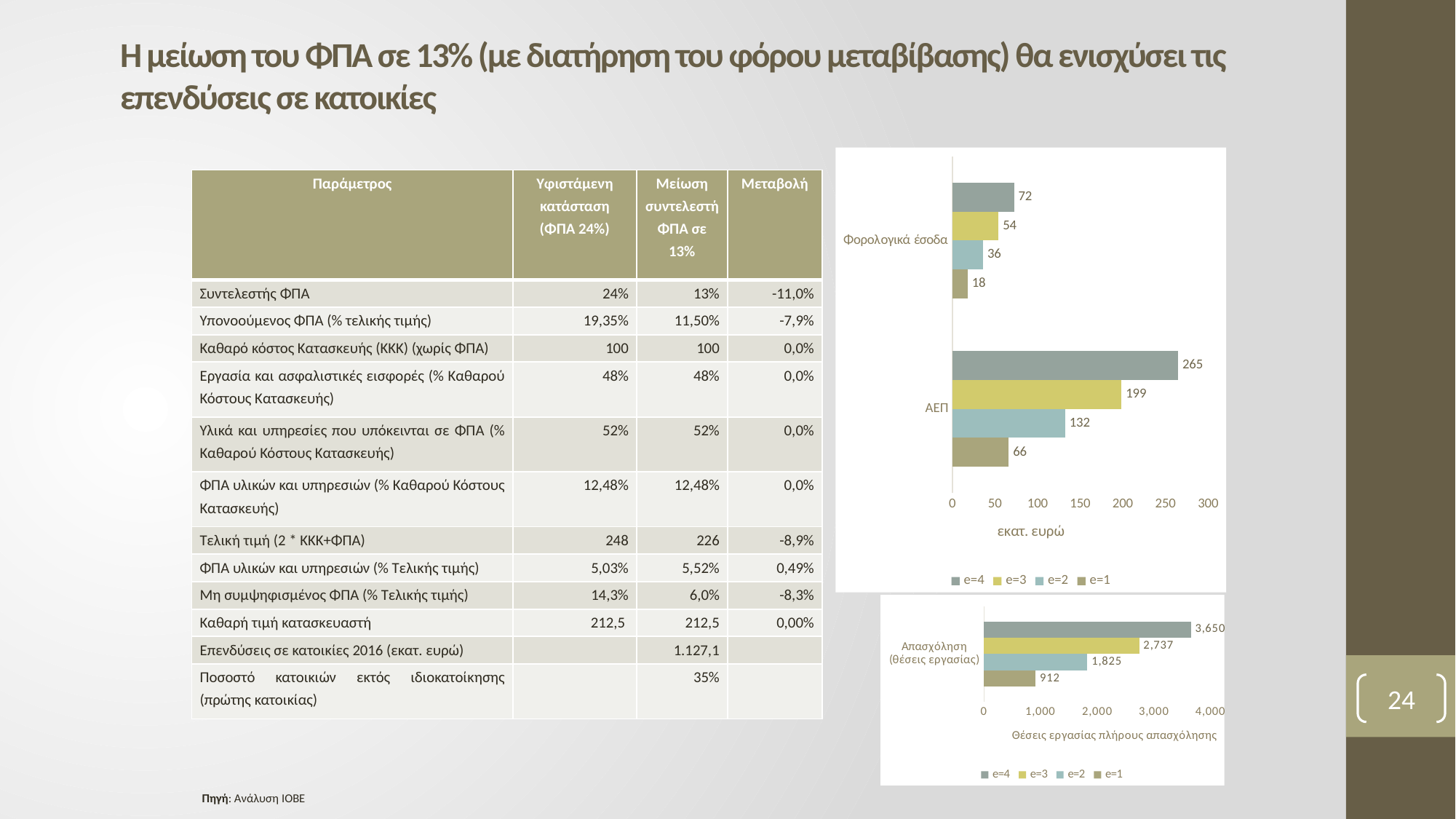
In the upper chart (εκατ. ευρώ), which series has the lowest value for Φορολογικά έσοδα? e=1 What kind of chart is the lower chart (Απασχόληση)? Bar chart In the upper chart (εκατ. ευρώ), what is the value of Φορολογικά έσοδα for e=2? 36 How many series does the legend of the upper chart (εκατ. ευρώ) list? 4 In the upper chart (εκατ. ευρώ), what is the difference between the ΑΕΠ values for e=4 and e=1? 199 In the lower chart (Απασχόληση), what is the difference between the values for e=4 and e=2? 1,825 In the upper chart (εκατ. ευρώ), which series has the highest value for ΑΕΠ? e=4 In the lower chart (Απασχόληση), what is the value for e=3? 2,737 In the upper chart (εκατ. ευρώ), which is larger: ΑΕΠ for e=3 or ΑΕΠ for e=2? ΑΕΠ for e=3 In the upper chart (εκατ. ευρώ), what is the value of Φορολογικά έσοδα for e=1? 18 In the upper chart (εκατ. ευρώ), what is the value of ΑΕΠ for e=4? 265 What is the x-axis label of the lower chart (Απασχόληση)? Θέσεις εργασίας πλήρους απασχόλησης